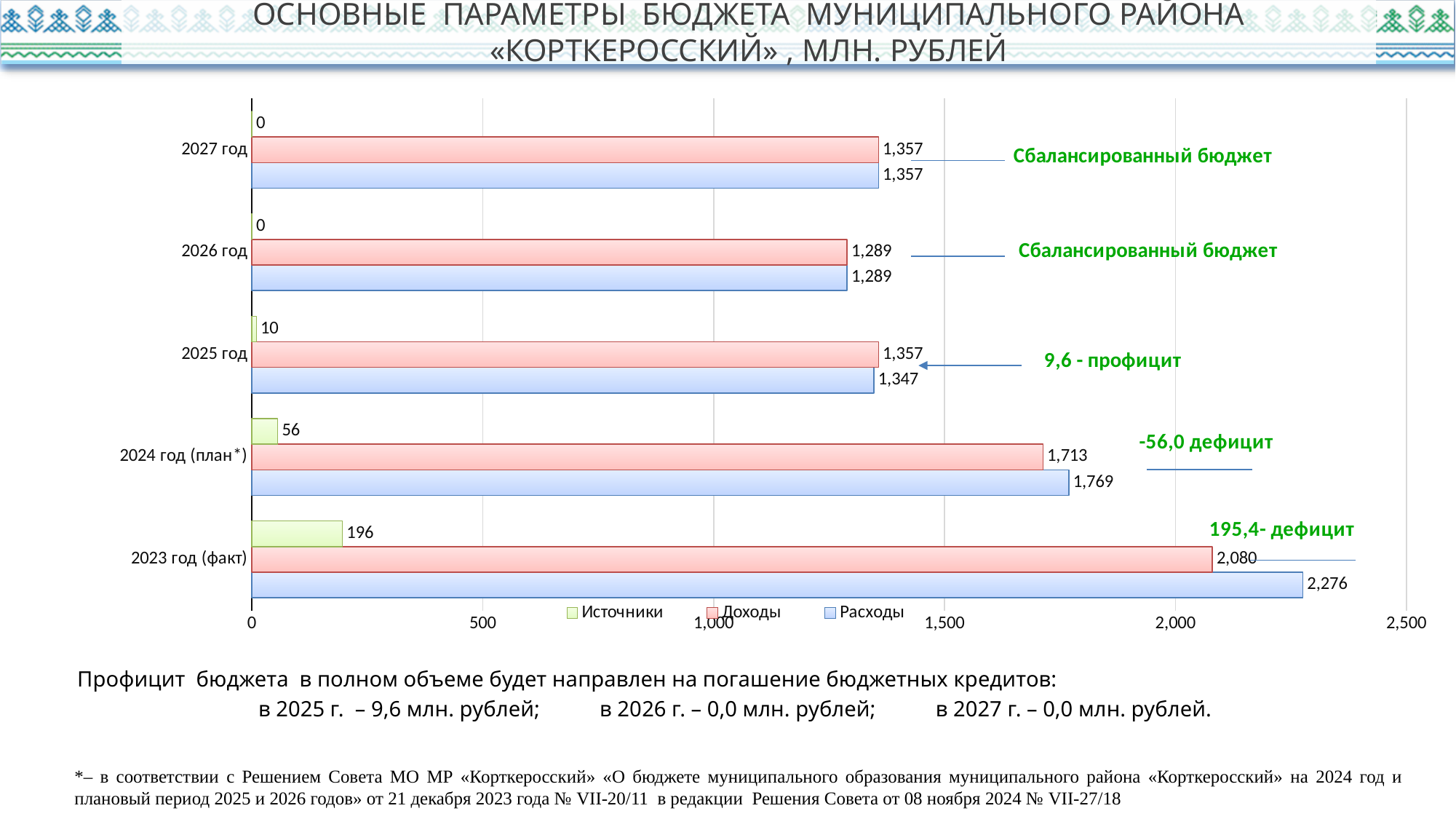
What type of chart is shown on the slide? Bar chart What is the difference between Расходы and Доходы for 2023 год (факт)? 196 What is the value of Доходы for 2026 год? 1,289 How many series does the legend list? 3 What is the value of Доходы for 2024 год (план*)? 1,713 Which is larger for 2024 год (план*): Доходы or Расходы? Расходы What is the value of Расходы for 2023 год (факт)? 2,276 How many year categories are shown on the chart? 5 What is the value of Источники for 2025 год? 10 Which year has the lowest value of Доходы? 2026 год Which year has the highest value of Расходы? 2023 год (факт) What is the difference between Источники for 2023 год (факт) and 2024 год (план*)? 140